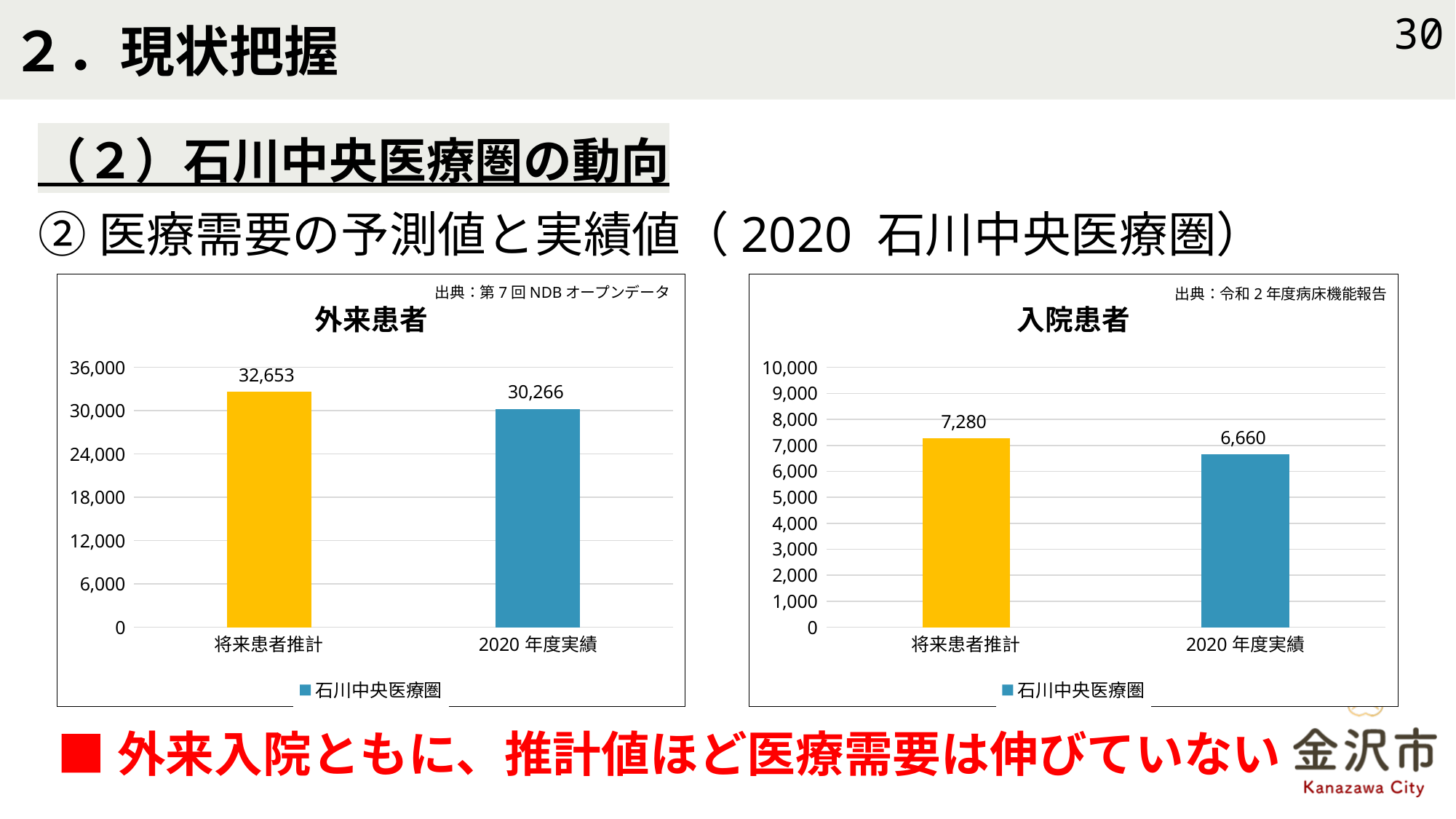
In the 入院患者 chart, which category has the lower value? 2020年度実績 In the 入院患者 chart, what is the value for 将来患者推計? 7,280 In the 入院患者 chart, what is the difference between 将来患者推計 and 2020年度実績? 620 In the 外来患者 chart, what is the value for 2020年度実績? 30,266 What is the legend entry shown in the 外来患者 chart? 石川中央医療圏 In the 入院患者 chart, is the value for 2020年度実績 greater or less than 7,000? less How many categories are shown in the 外来患者 chart? 2 In the 外来患者 chart, what is the difference between 将来患者推計 and 2020年度実績? 2,387 In the 外来患者 chart, which category has the higher value? 将来患者推計 What kind of chart is the 入院患者 chart? bar chart In the 外来患者 chart, what is the value for 将来患者推計? 32,653 In the 入院患者 chart, what is the value for 2020年度実績? 6,660